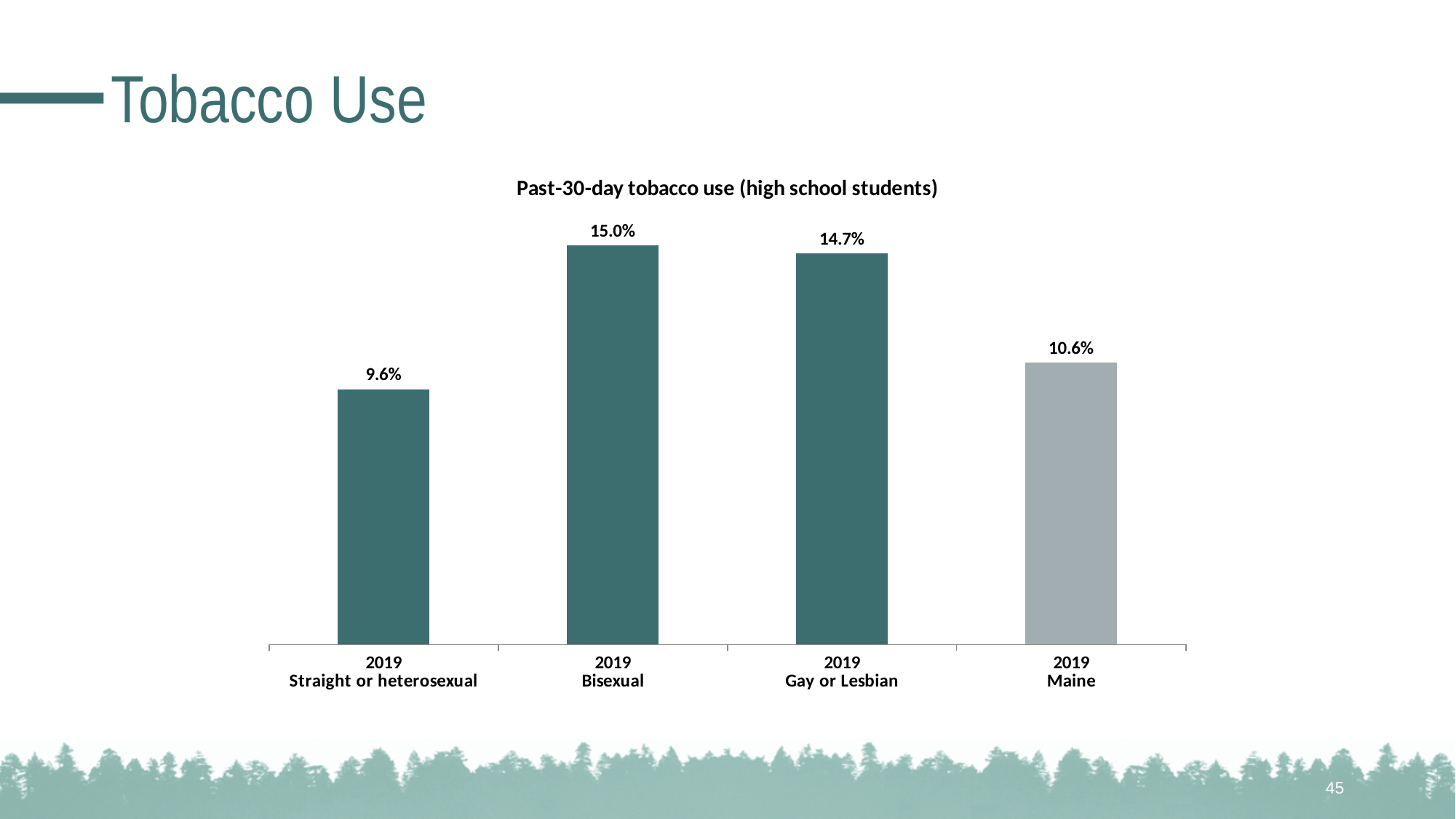
What is the difference between the Gay or Lesbian value and the Maine value? 4.1% What is the past-30-day tobacco use value for Maine? 10.6% What is the difference between the Bisexual and Straight or heterosexual values? 5.4% Which category has the highest past-30-day tobacco use? Bisexual What is the past-30-day tobacco use value for Straight or heterosexual high school students? 9.6% What is the title of the chart? Past-30-day tobacco use (high school students) How many bars are shown in the chart? 4 What is the past-30-day tobacco use value for Gay or Lesbian high school students? 14.7% What is the past-30-day tobacco use value for Bisexual high school students? 15.0% Which category has the lowest past-30-day tobacco use? Straight or heterosexual What kind of chart is shown on the slide? Bar chart Which is larger, the value for Maine or the value for Straight or heterosexual? Maine